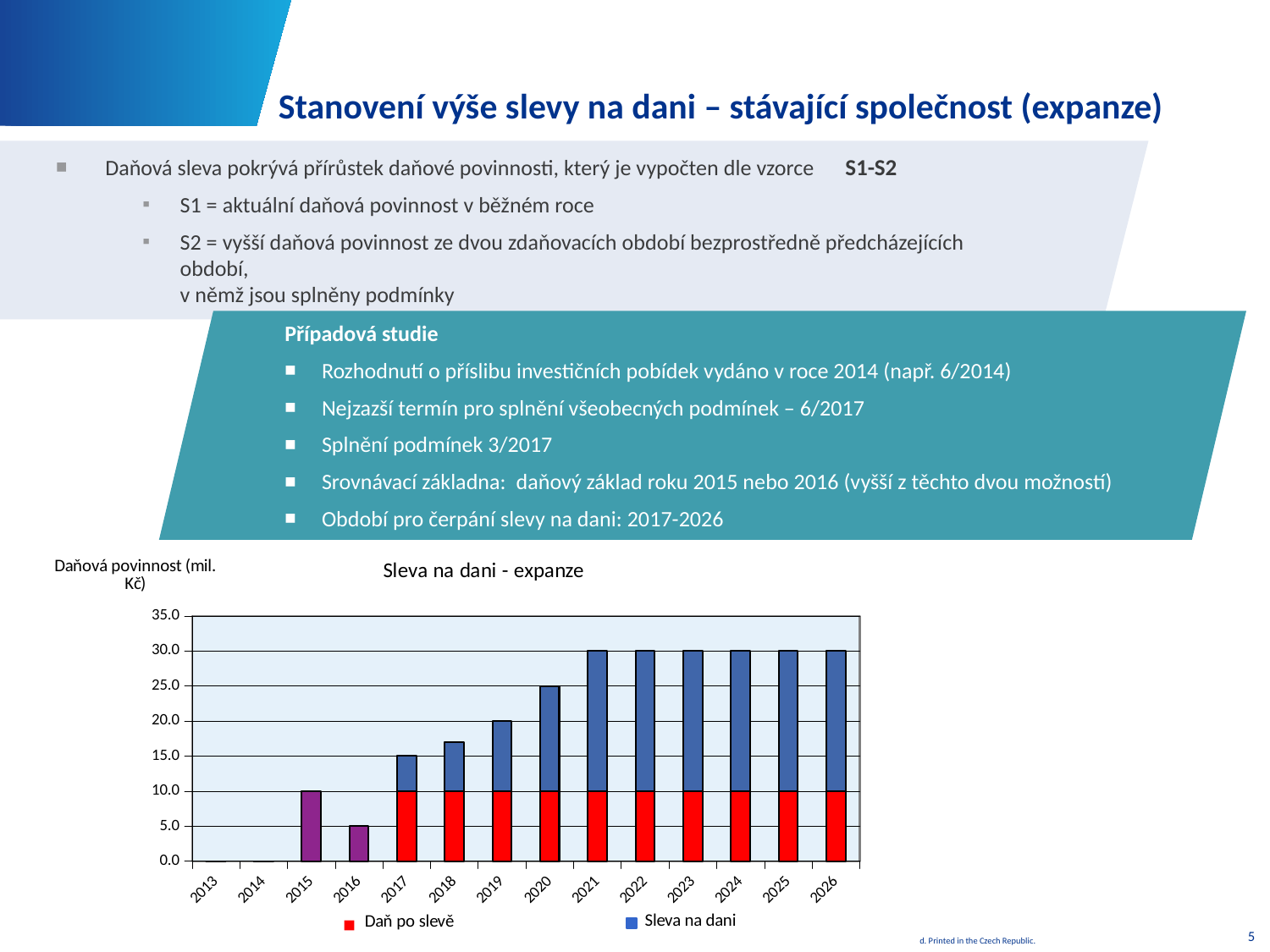
Do the total bar heights rise or fall from 2017 to 2021? rise What is the value of the bar for 2015? 10.0 What is the total height of the stacked bar for 2021? 30.0 How many years are shown on the x axis of the chart? 14 What kind of chart is shown on the slide? bar chart Which year has the larger total bar, 2017 or 2020? 2020 How many series does the chart legend list? 2 Is the value for 2016 greater or less than 10.0? less What is the title of the chart? Sleva na dani - expanze Is the total value for 2018 greater or less than 15.0? greater What is the value of the 'Daň po slevě' segment for 2019? 10.0 What label is given to the vertical axis of the chart? Daňová povinnost (mil. Kč)